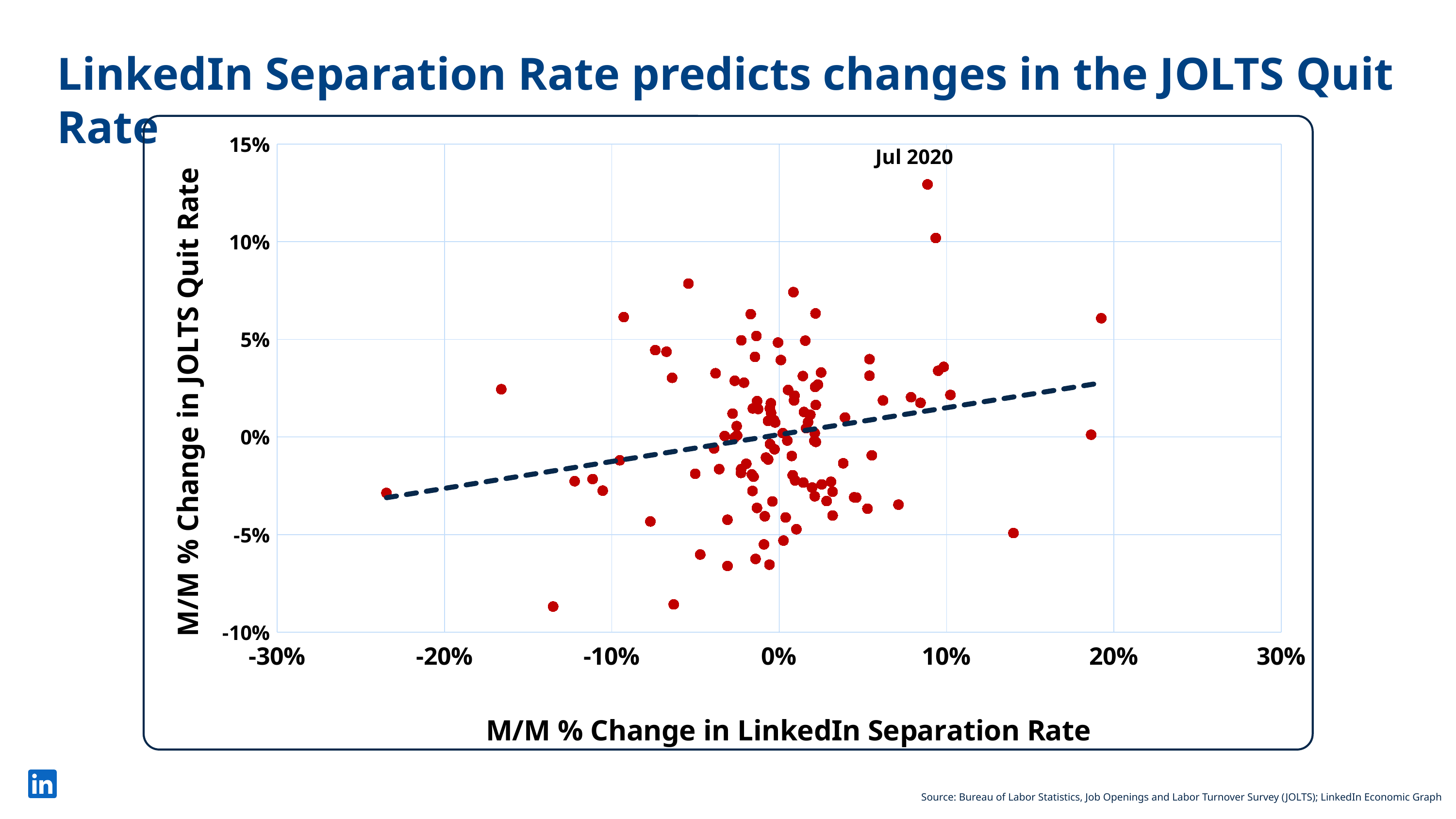
What is the maximum value shown on the y axis? 15% What is the minimum value shown on the x axis? -30% Is the M/M % change in JOLTS Quit Rate for the Jul 2020 point greater or less than 10%? greater Is the M/M % change in JOLTS Quit Rate for the leftmost point (near -23% on the x axis) greater or less than 0%? less What is the label of the y axis? M/M % Change in JOLTS Quit Rate Is the M/M % change in JOLTS Quit Rate for the point near 19% on the x axis (the rightmost upper point) greater or less than 5%? greater Does the dashed trend line rise or fall as the M/M % change in LinkedIn Separation Rate increases? rises Which labeled point has the highest M/M % change in JOLTS Quit Rate? Jul 2020 What kind of chart is shown on the slide? Scatter chart What is the label of the x axis? M/M % Change in LinkedIn Separation Rate